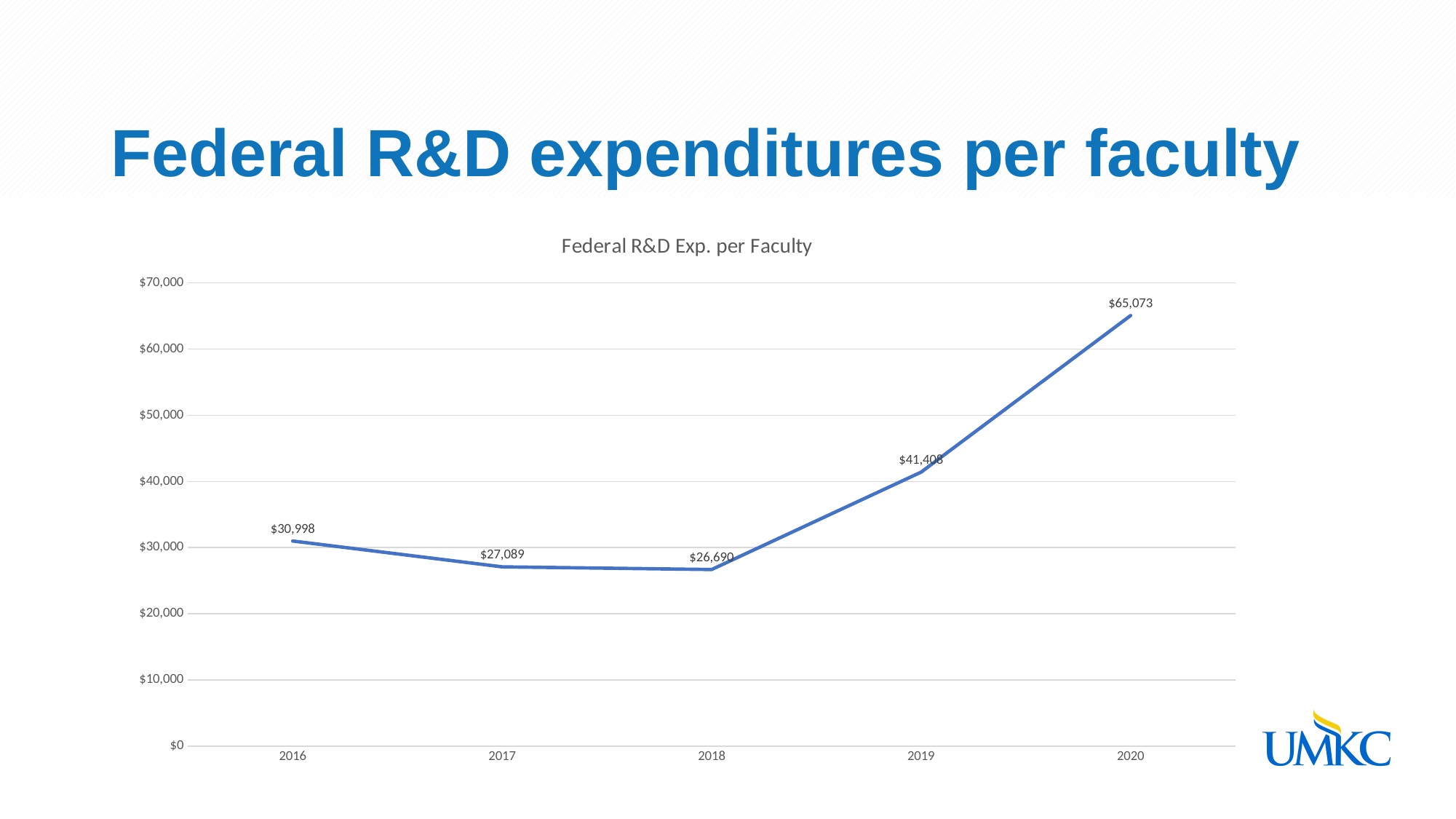
What is the Federal R&D expenditure per faculty in 2018? $26,690 What is the Federal R&D expenditure per faculty in 2017? $27,089 What is the Federal R&D expenditure per faculty in 2020? $65,073 Which year has the highest Federal R&D expenditure per faculty? 2020 Is the value for 2019 greater or less than $40,000? greater Which year has a larger value, 2016 or 2017? 2016 What is the title shown above the chart? Federal R&D Exp. per Faculty What is the difference between the 2020 and 2016 values? $34,075 What type of chart is shown on the slide? Line chart What is the Federal R&D expenditure per faculty in 2016? $30,998 How many years are plotted on the chart? 5 Which year has the lowest Federal R&D expenditure per faculty? 2018